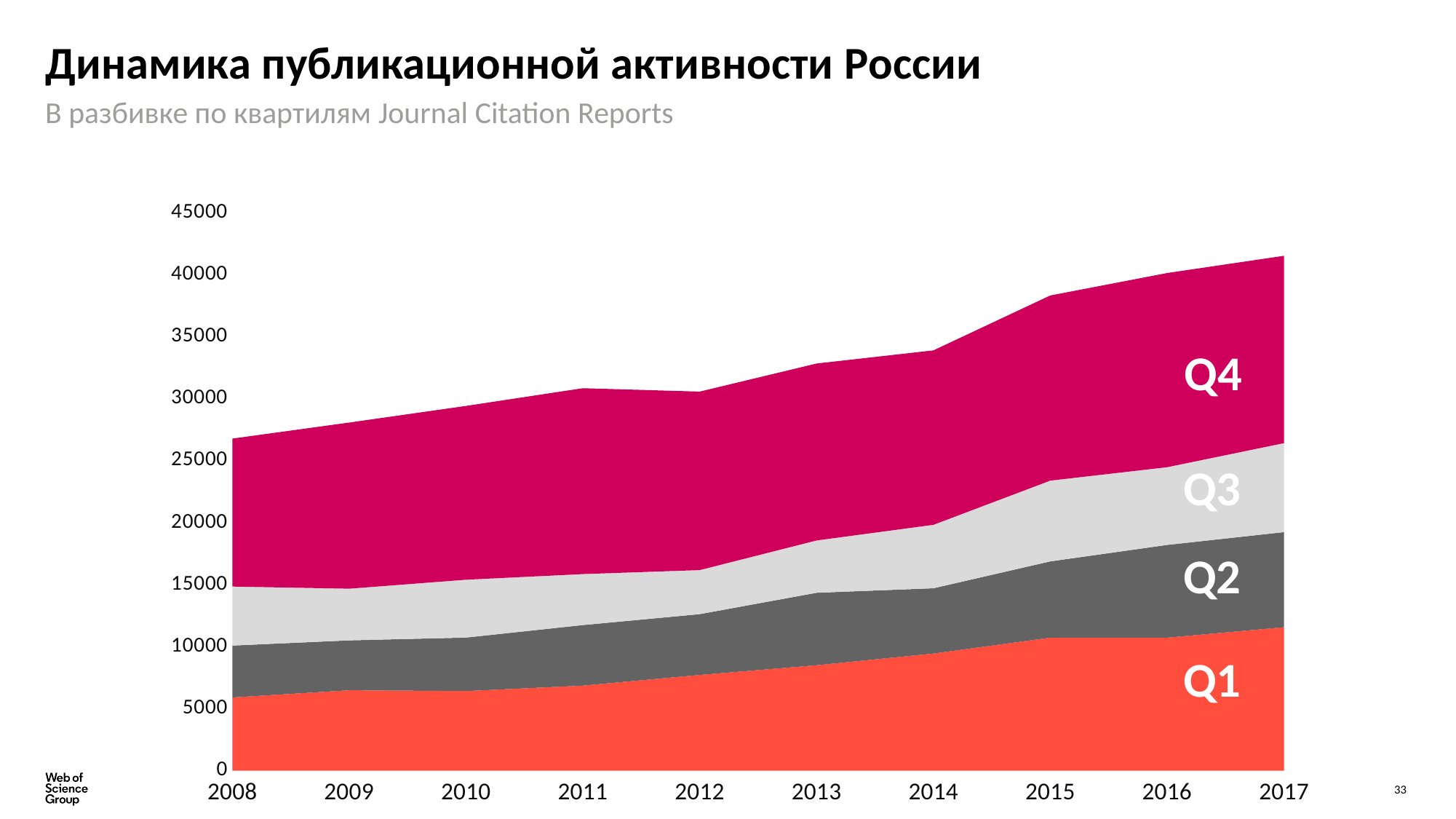
Is the Q1 value for 2017 greater or less than 10000? greater Is the total value for 2008 greater or less than 30000? less Is the total value for 2015 greater or less than 35000? greater Which year has the larger total, 2008 or 2017? 2017 Which series is plotted at the bottom of the stacked areas? Q1 What kind of chart is shown on the slide? Stacked area chart How many years are shown along the x axis of the chart? 10 Does the total number of publications rise or fall from 2008 to 2017? Rise How many series (quartiles) are shown in the chart? 4 What is the title of the slide? Динамика публикационной активности России